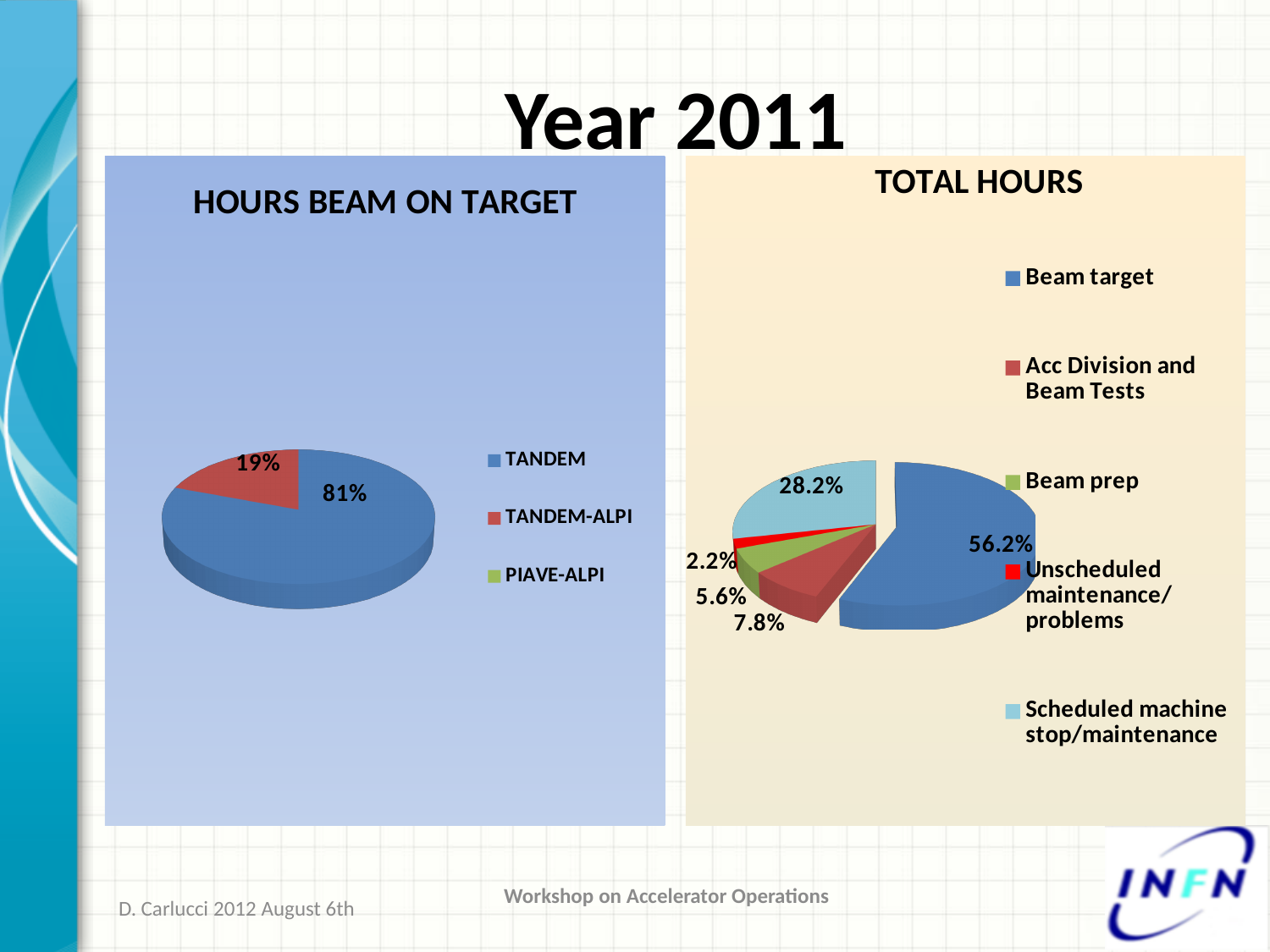
In the "HOURS BEAM ON TARGET" chart, which category has the largest slice? TANDEM In the "TOTAL HOURS" chart, which category has the smallest slice? Unscheduled maintenance/problems How many entries does the legend of the "TOTAL HOURS" chart list? 5 How many entries does the legend of the "HOURS BEAM ON TARGET" chart list? 3 In the "TOTAL HOURS" chart, what share does Scheduled machine stop/maintenance have? 28.2% In the "HOURS BEAM ON TARGET" chart, what is the difference between the TANDEM and TANDEM-ALPI shares? 62% In the "HOURS BEAM ON TARGET" chart, what share does TANDEM-ALPI have? 19% What kind of chart is the "HOURS BEAM ON TARGET" chart? Pie chart In the "TOTAL HOURS" chart, what share does Beam target have? 56.2% In the "TOTAL HOURS" chart, which is larger: Beam prep or Acc Division and Beam Tests? Acc Division and Beam Tests